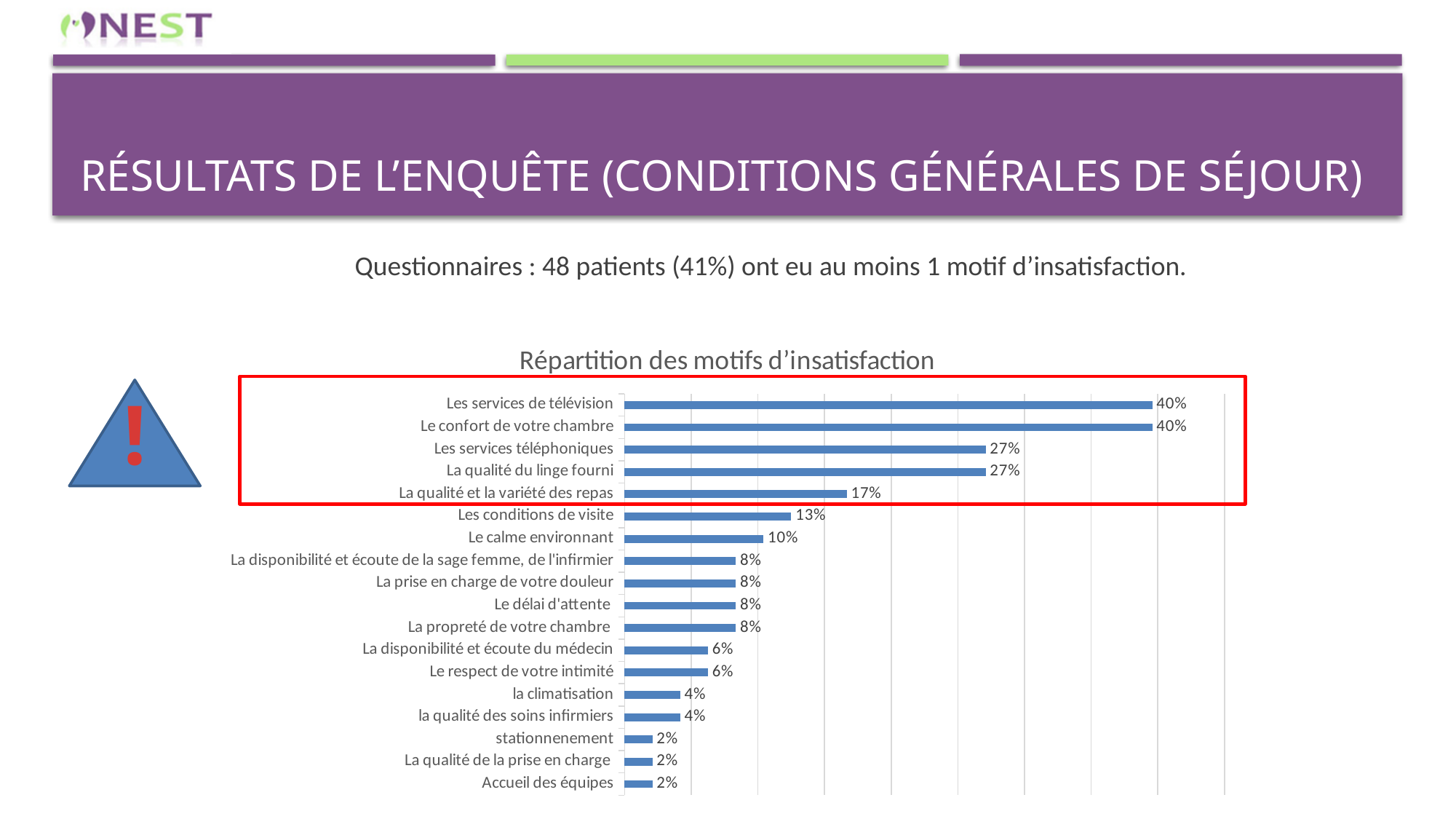
What is the value for 'Accueil des équipes'? 2% What is the value for 'Les conditions de visite'? 13% What is the value for 'Les services téléphoniques'? 27% What is the value for 'Le calme environnant'? 10% What is the difference between the values for 'Les conditions de visite' and 'Le respect de votre intimité'? 7% What is the difference between the values for 'Les services de télévision' and 'La qualité du linge fourni'? 13% What is the value for 'La qualité et la variété des repas'? 17% How many categories are shown in the chart? 18 What is the title of the chart? Répartition des motifs d'insatisfaction Which is larger, the value for 'Le calme environnant' or the value for 'Le délai d'attente'? Le calme environnant What kind of chart is shown on the slide? Bar chart What is the value for 'la climatisation'? 4%